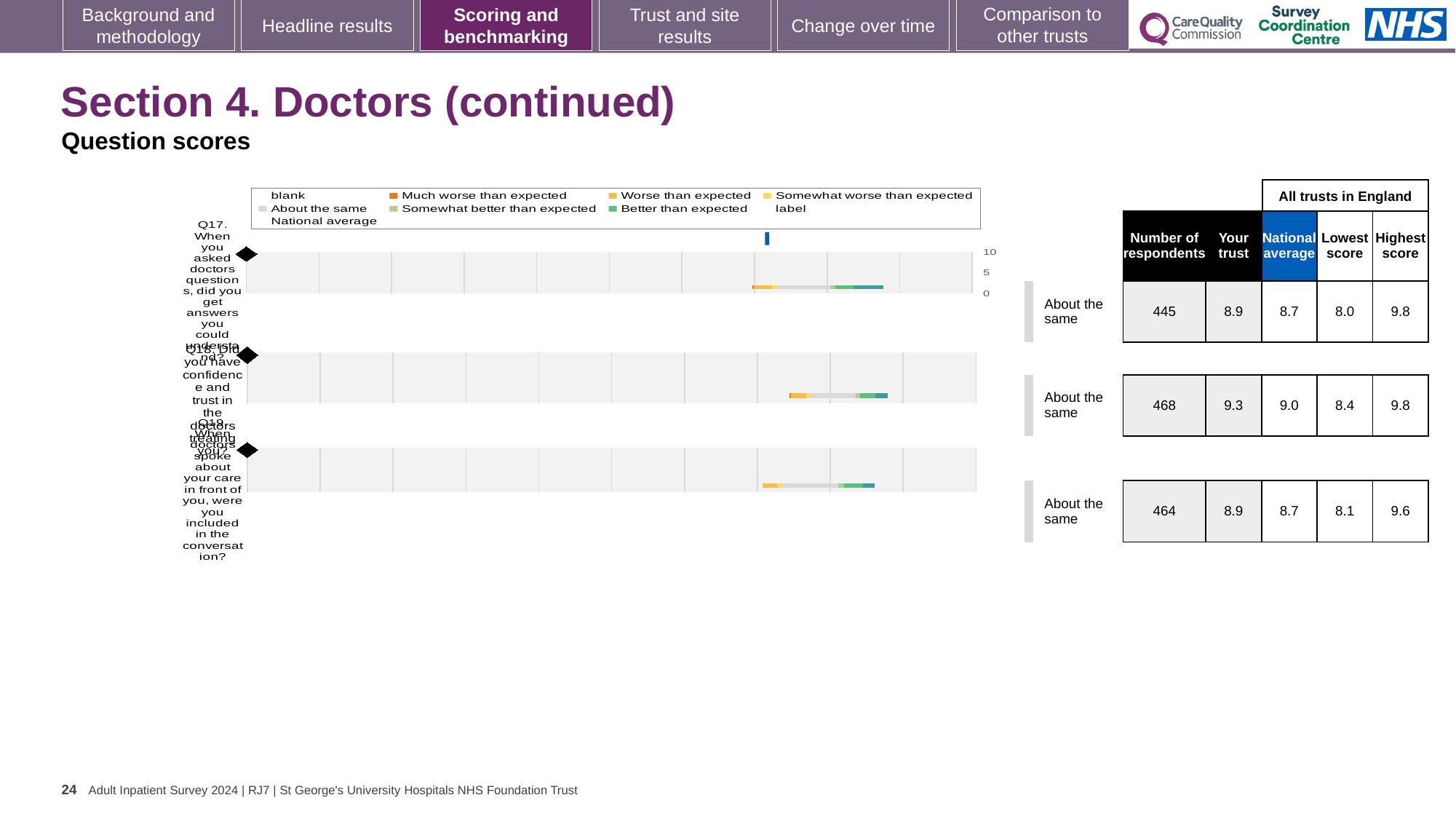
What benchmark category is shown for all three questions on this slide? About the same For Q17, is the 'Your trust' score higher or lower than the national average? higher Which question has the highest 'Your trust' score? Q18 What is the difference between the 'Your trust' score and the national average for Q18? 0.3 How many questions (Q17, Q18, Q19) are plotted in the chart? 3 What is the maximum value shown on the chart's score axis? 10 What is the lowest score across all trusts in England for Q18? 8.4 What is the 'Your trust' score for Q17 (When you asked doctors questions, did you get answers you could understand)? 8.9 How many respondents answered Q19 (When doctors spoke about your care in front of you, were you included in the conversation)? 464 What is the national average score for Q18 (Did you have confidence and trust in the doctors treating you)? 9.0 What is the highest score across all trusts in England for Q19? 9.6 What kind of chart is used to show the question scores on this slide? bar chart